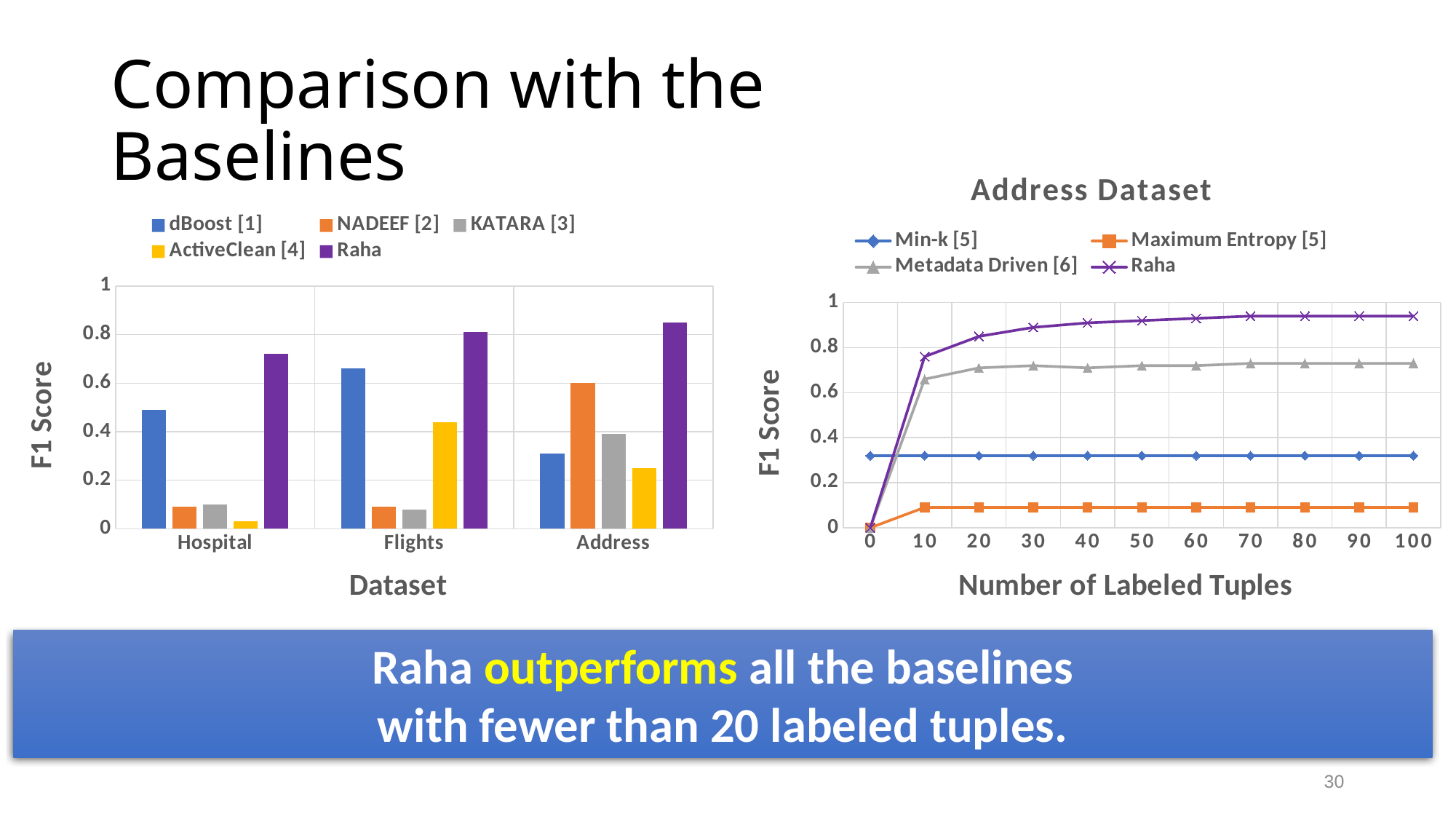
How many datasets are shown on the x axis of the left bar chart? 3 In the 'Address Dataset' chart, does the F1 Score of Min-k [5] rise, fall, or stay flat as the number of labeled tuples increases from 10 to 100? stay flat What is the x-axis label of the 'Address Dataset' chart? Number of Labeled Tuples On the left bar chart, which is larger for the Address dataset: the F1 Score of NADEEF [2] or KATARA [3]? NADEEF [2] In the 'Address Dataset' chart, which series has the lowest F1 Score at 100 labeled tuples? Maximum Entropy [5] On the left bar chart, is the F1 Score of dBoost [1] for the Address dataset greater or less than 0.4? less On the left bar chart, is the F1 Score of Raha for the Flights dataset greater or less than 0.8? greater What kind of chart is the chart titled 'Address Dataset'? line chart On the left bar chart, which series has the highest F1 Score for the Hospital dataset? Raha In the 'Address Dataset' chart, is the F1 Score of Raha at 50 labeled tuples greater or less than 0.8? greater How many series does the legend of the left bar chart list? 5 On the left bar chart, which series has the lowest F1 Score for the Hospital dataset? ActiveClean [4]